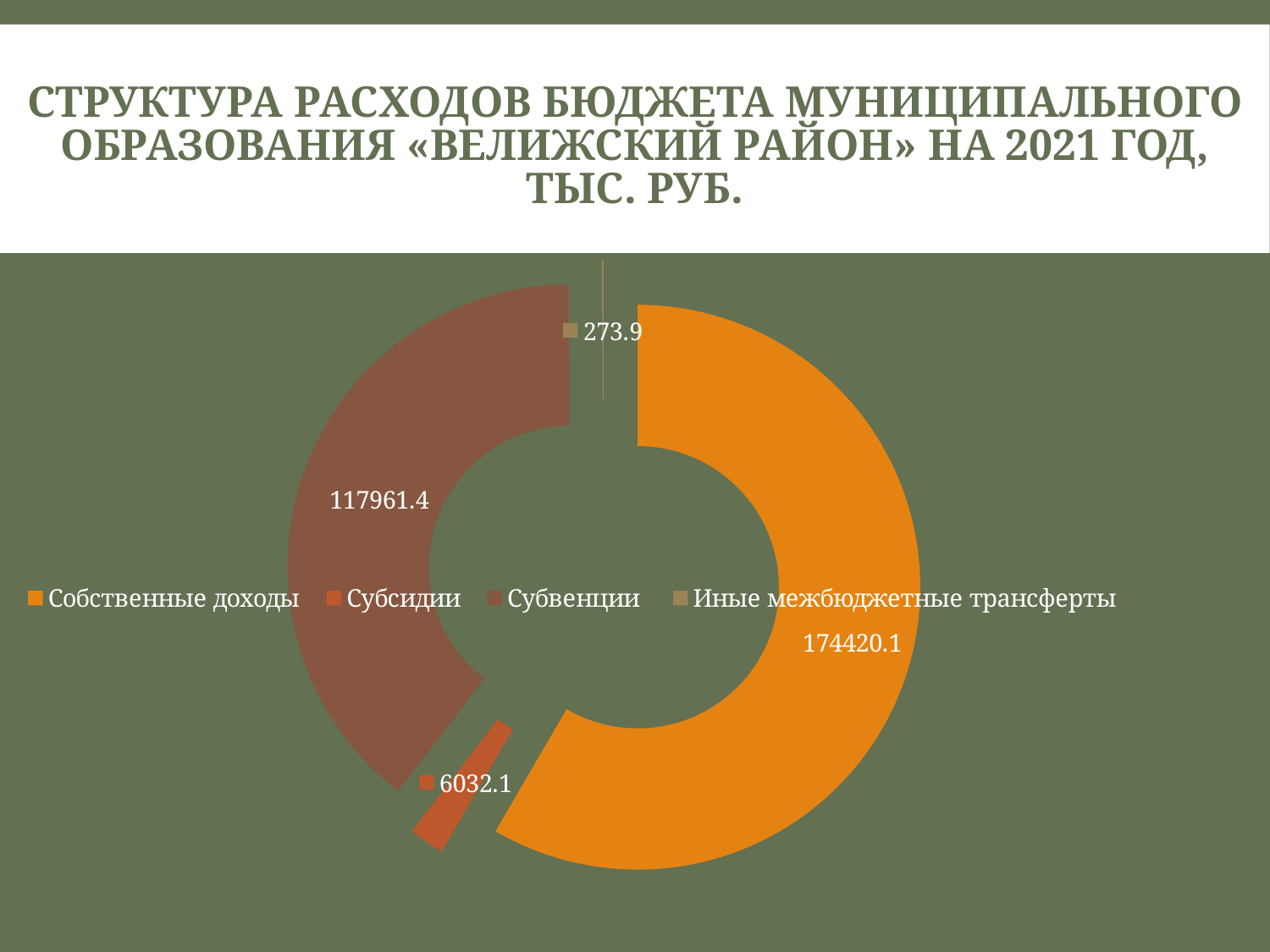
What value is shown for Субвенции? 117961.4 What value is shown for Собственные доходы? 174420.1 Which is larger, Субсидии or Субвенции? Субвенции Which category has the largest value? Собственные доходы What kind of chart is shown on the slide? Doughnut (pie) chart What is the total of all four categories shown in the chart? 298687.5 What value is shown for Иные межбюджетные трансферты? 273.9 How many categories does the chart show? 4 What is the difference between Субсидии and Иные межбюджетные трансферты? 5758.2 What is the difference between Собственные доходы and Субвенции? 56458.7 Which category has the smallest value? Иные межбюджетные трансферты What value is shown for Субсидии? 6032.1